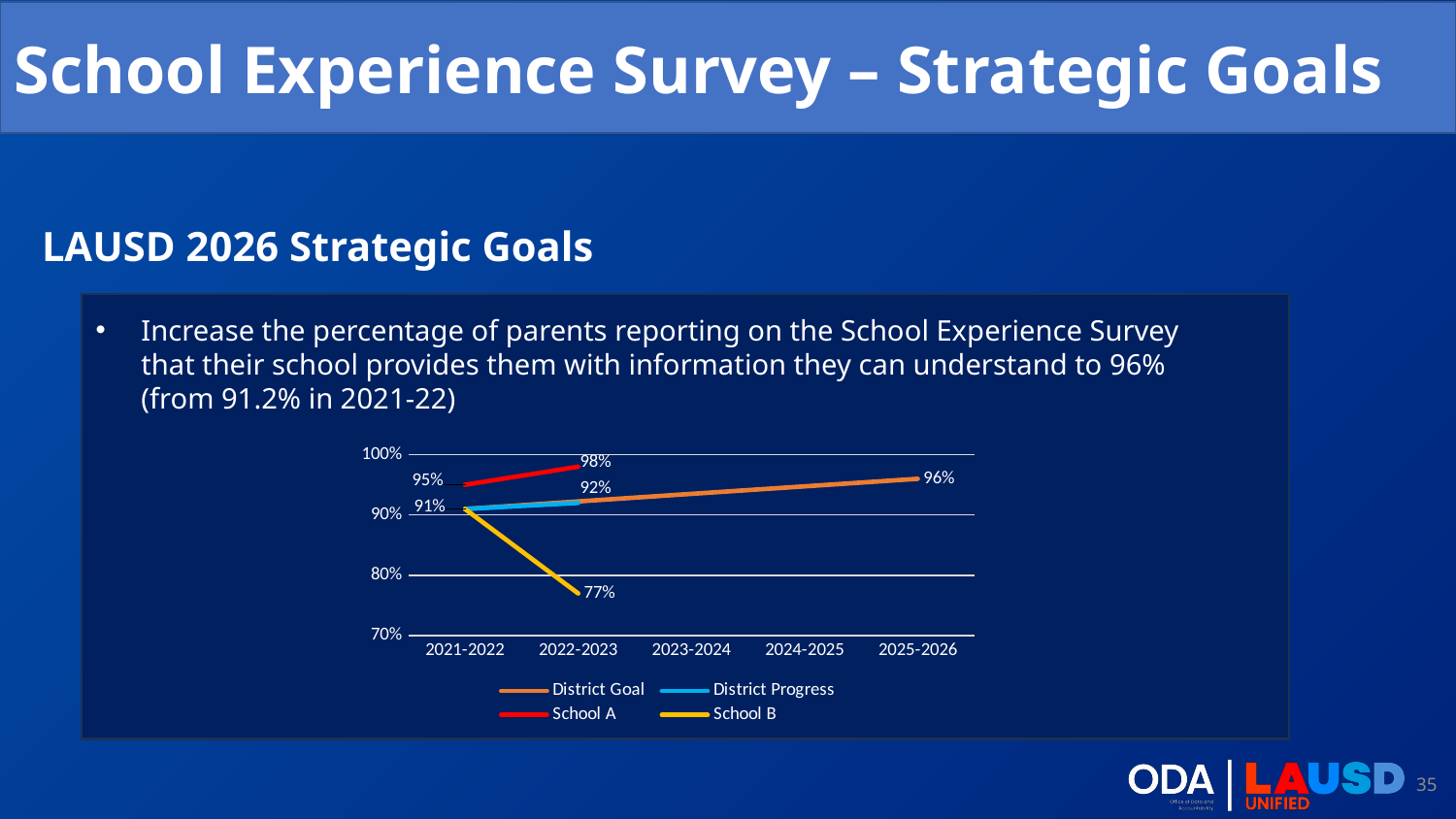
How many school years are shown on the x axis of the chart? 5 What colour is the School B line in the chart? yellow Which is higher in 2022-2023, School A or School B? School A What is the District Progress value in 2022-2023? 92% What is the District Goal value shown for 2025-2026? 96% What is the value for School A in 2022-2023? 98% What kind of chart is shown on the slide? line chart What is the value for School B in 2022-2023? 77% How many series does the chart's legend list? 4 What is the difference between School A and School B in 2022-2023? 21 percentage points Does the School B line rise or fall from 2021-2022 to 2022-2023? fall What is the value for School A in 2021-2022? 95%